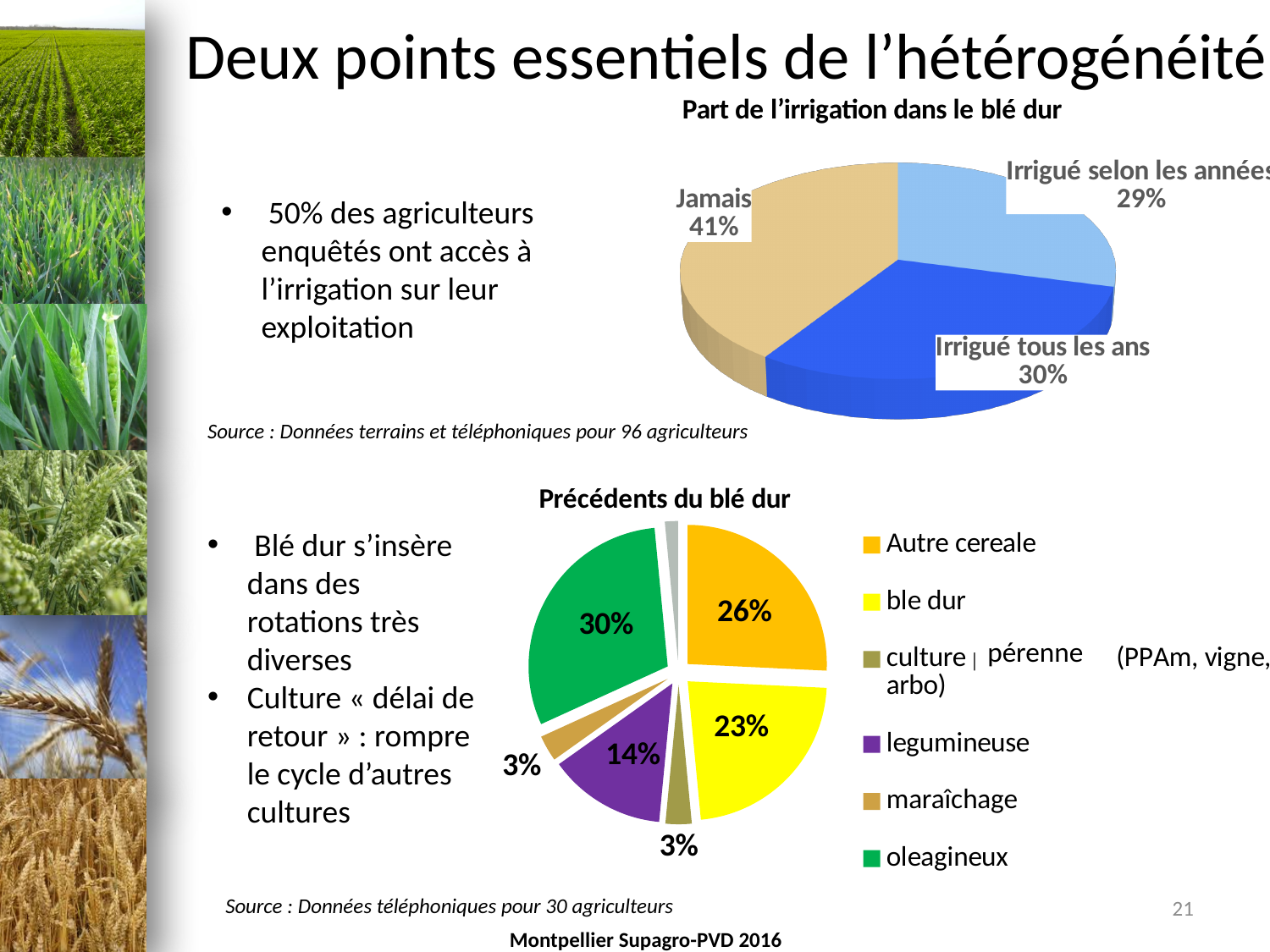
In the chart 'Précédents du blé dur', what share is shown for 'oleagineux'? 30% In the chart 'Part de l'irrigation dans le blé dur', what share is labelled 'Irrigué tous les ans'? 30% In the chart 'Part de l'irrigation dans le blé dur', what share is labelled 'Jamais'? 41% In the chart 'Part de l'irrigation dans le blé dur', which category has the smallest share? Irrigué selon les années In the chart 'Part de l'irrigation dans le blé dur', what is the difference in percentage points between 'Jamais' and 'Irrigué selon les années'? 12 In the chart 'Précédents du blé dur', what share is shown for 'ble dur'? 23% How many entries does the legend of the chart 'Précédents du blé dur' list? 6 In the chart 'Précédents du blé dur', what share is shown for 'legumineuse'? 14% In the chart 'Précédents du blé dur', what is the difference in percentage points between 'oleagineux' and 'legumineuse'? 16 In the chart 'Précédents du blé dur', which is larger, 'Autre cereale' or 'ble dur'? Autre cereale In the chart 'Part de l'irrigation dans le blé dur', which category has the largest share? Jamais What kind of chart is 'Part de l'irrigation dans le blé dur'? Pie chart